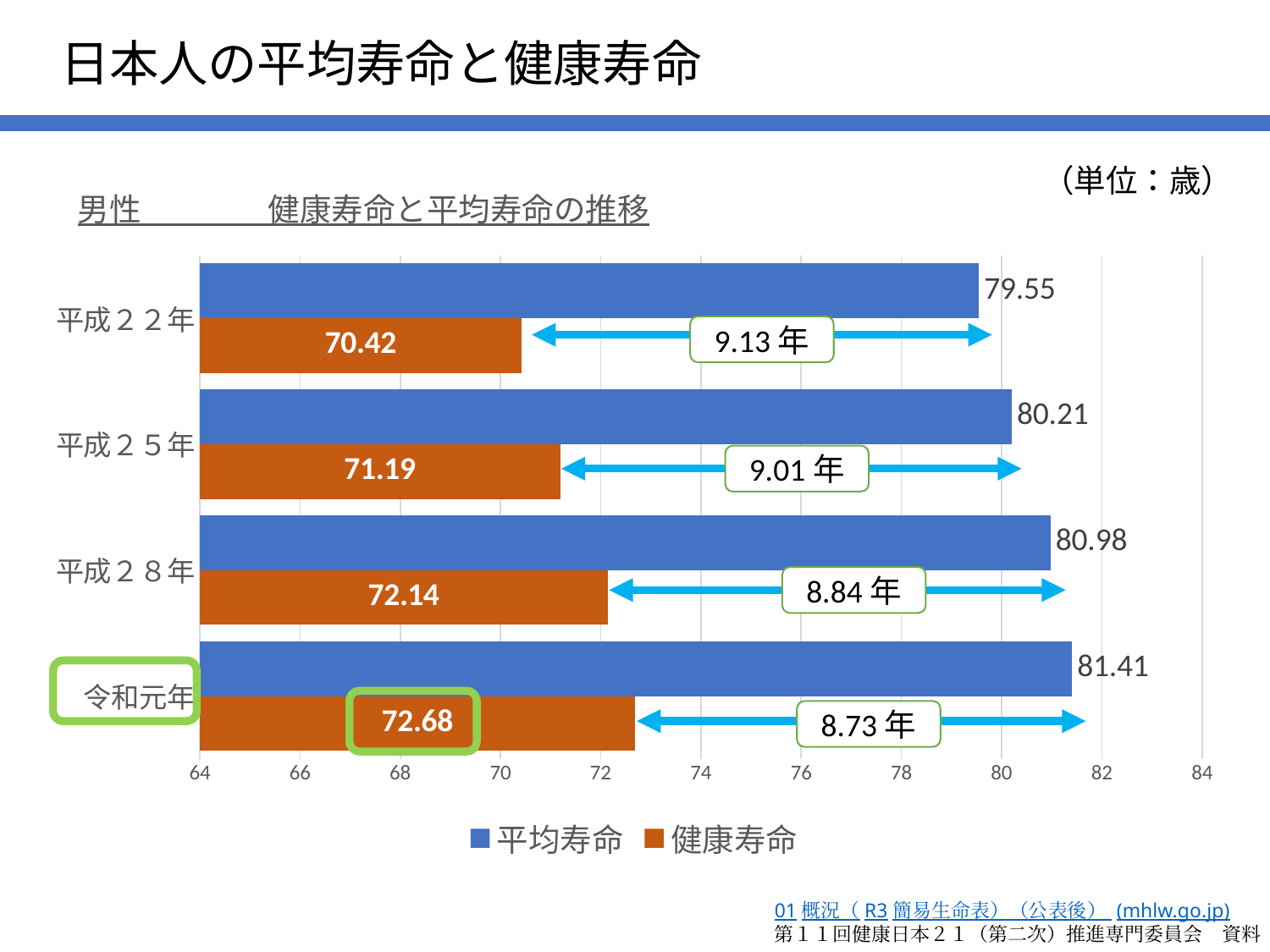
Which category has the lowest 健康寿命 value? 平成２２年 Is the 健康寿命 value for 令和元年 greater or less than 72? greater Do the 平均寿命 values rise or fall from 平成２２年 to 令和元年? rise What is the 健康寿命 value for 平成２２年? 70.42 How many series does the legend list? 2 What kind of chart is shown on the slide? bar chart What is the 平均寿命 value for 令和元年? 81.41 What is the 健康寿命 value for 平成２８年? 72.14 Which is larger, the 健康寿命 value for 平成２５年 or for 平成２８年? 平成２８年 What is the difference between 平均寿命 and 健康寿命 for 平成２５年? 9.01 年 Which category has the highest 平均寿命 value? 令和元年 How many categories (years) are shown on the chart? 4